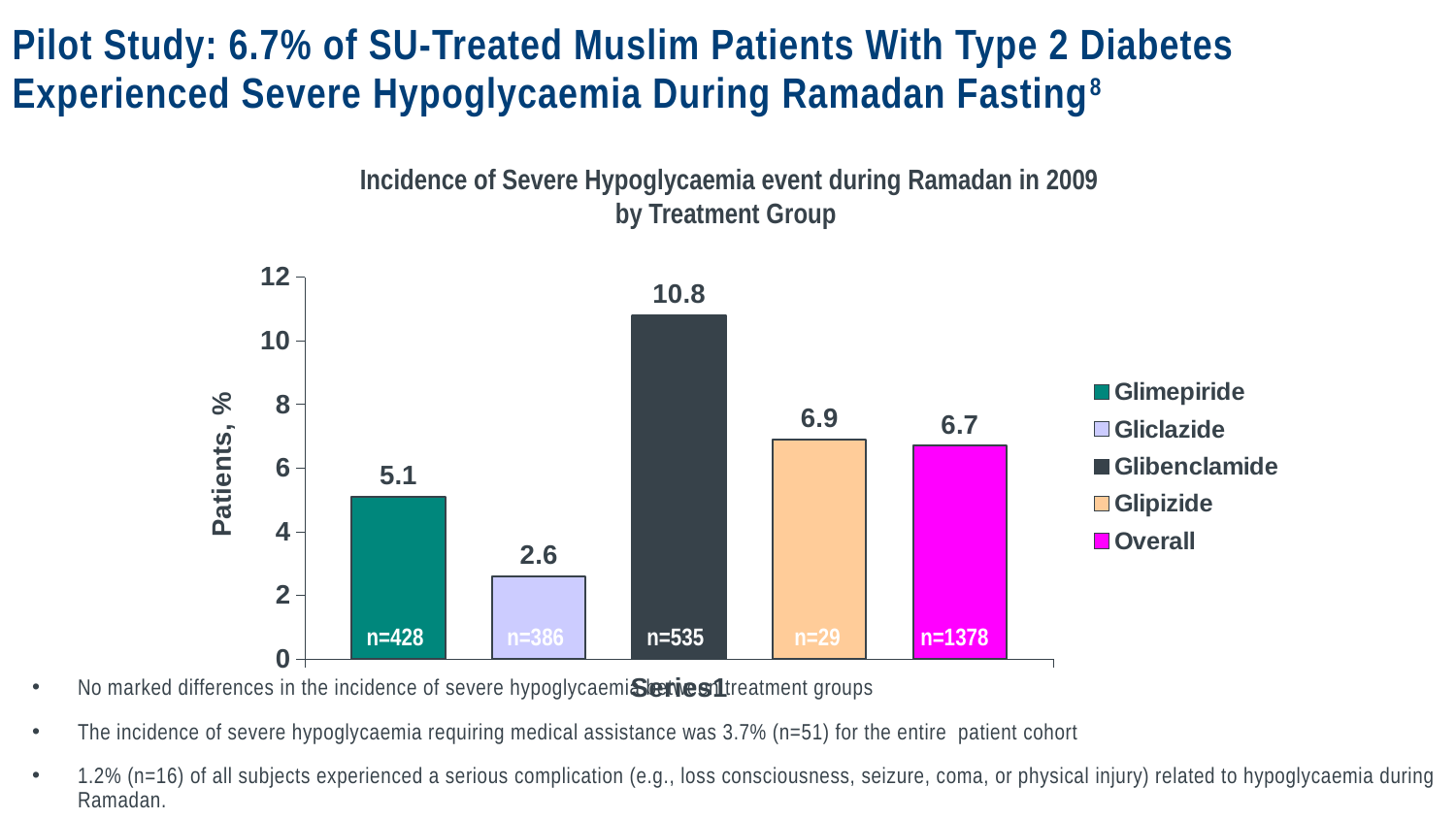
How many bars are shown in the chart? 5 Which treatment group has the lowest incidence of severe hypoglycaemia? Gliclazide What is the difference between the values for Glibenclamide and Gliclazide? 8.2 What is the label of the y axis? Patients, % What kind of chart is shown on the slide? Bar chart Which treatment group has the highest incidence of severe hypoglycaemia? Glibenclamide What is the value for Glimepiride? 5.1 How many entries does the legend list? 5 What is the value for Gliclazide? 2.6 Which is larger, the value for Glipizide or the value for Glimepiride? Glipizide What is the value for Overall? 6.7 What is the value for Glibenclamide? 10.8